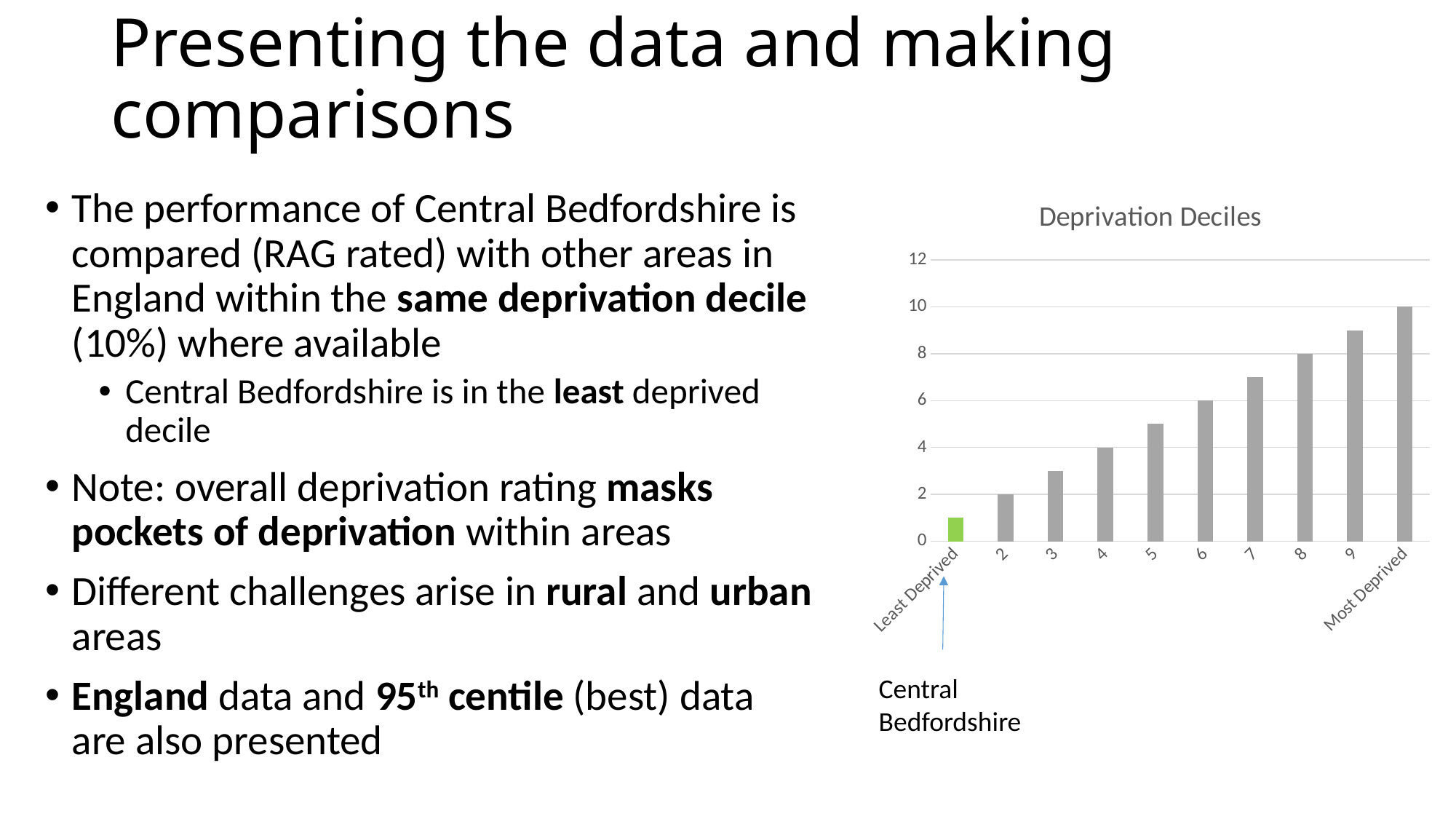
Which category has the highest bar in the Deprivation Deciles chart? Most Deprived What is the value of the bar for category 8? 8 What is the title of the chart? Deprivation Deciles What kind of chart is shown on the slide? bar chart How many bars are plotted in the Deprivation Deciles chart? 10 What is the value of the bar for category 4? 4 Is the value for Least Deprived greater or less than 2? less What is the difference between the Most Deprived bar and the bar for category 2? 8 Which category has the lowest bar in the Deprivation Deciles chart? Least Deprived Which is larger, the bar for category 7 or the bar for category 3? category 7 What is the value of the Most Deprived bar? 10 Do the bar values rise or fall from Least Deprived to Most Deprived along the x axis? rise